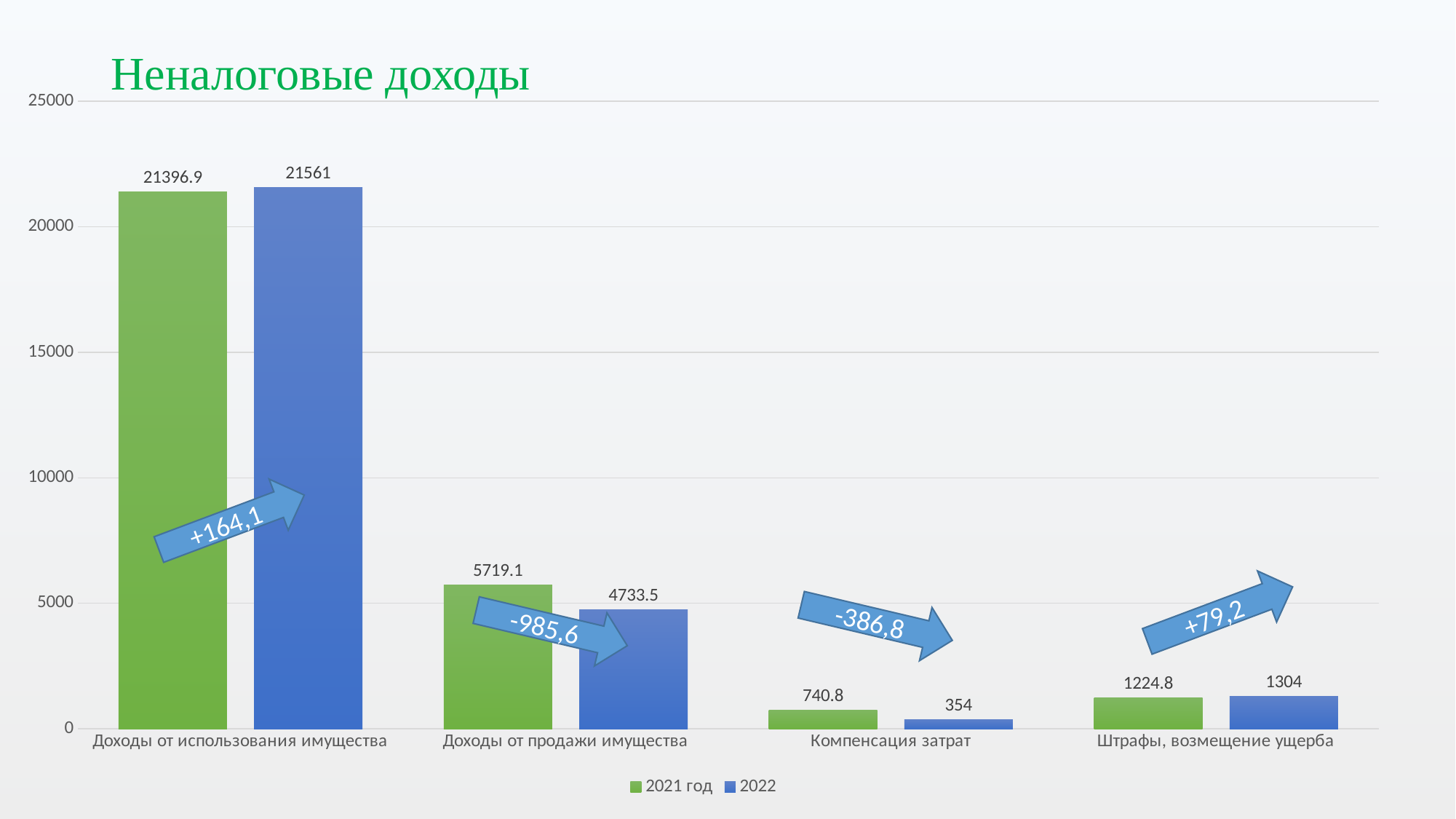
Which category has the highest 2022 value? Доходы от использования имущества What is the 2022 value for Компенсация затрат? 354 How many categories are shown on the x axis? 4 How many series does the legend list? 2 What is the difference between the 2022 and 2021 год values for Доходы от продажи имущества? 985.6 What is the 2021 год value for Доходы от использования имущества? 21396.9 What is the title of the chart? Неналоговые доходы Which category has the lowest 2021 год value? Компенсация затрат What is the 2022 value for Доходы от продажи имущества? 4733.5 What is the 2021 год value for Штрафы, возмещение ущерба? 1224.8 Which is larger for Компенсация затрат: the 2021 год value or the 2022 value? 2021 год What is the difference between the 2022 and 2021 год values for Штрафы, возмещение ущерба? 79.2